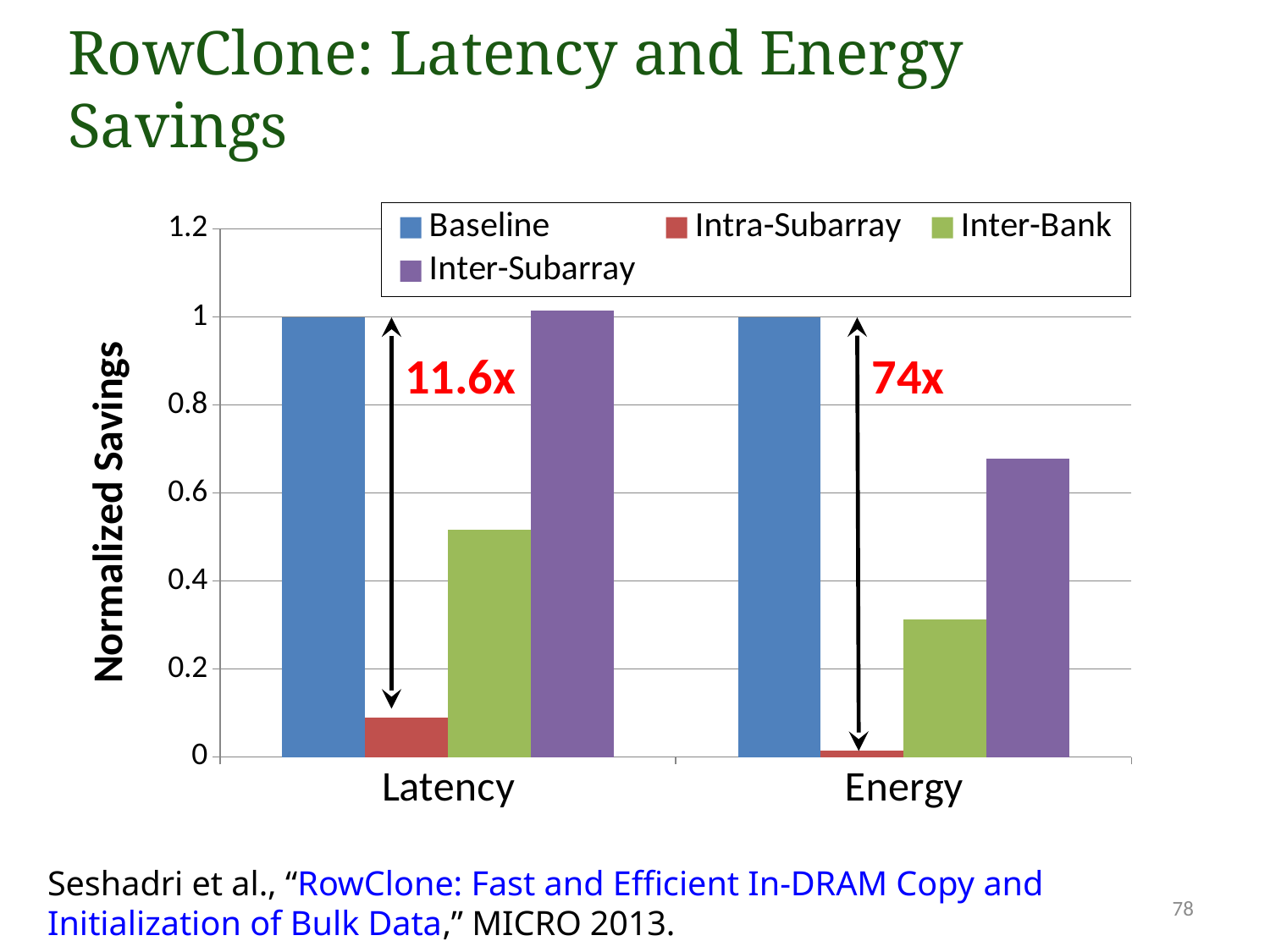
What is the Baseline value for Energy? 1 What kind of chart is shown on the slide? bar chart What is the Baseline value for Latency? 1 Is the Inter-Bank value for Latency greater or less than 0.4? greater Is the Inter-Subarray value for Energy greater or less than 0.6? greater Which series has the lowest value for Energy? Intra-Subarray Is the Inter-Bank value for Energy greater or less than 0.4? less How many series does the legend list? 4 Which series has the highest value for Energy? Baseline What is the label on the y axis? Normalized Savings For Latency, which is larger: Inter-Bank or Inter-Subarray? Inter-Subarray How many categories are shown on the x axis? 2